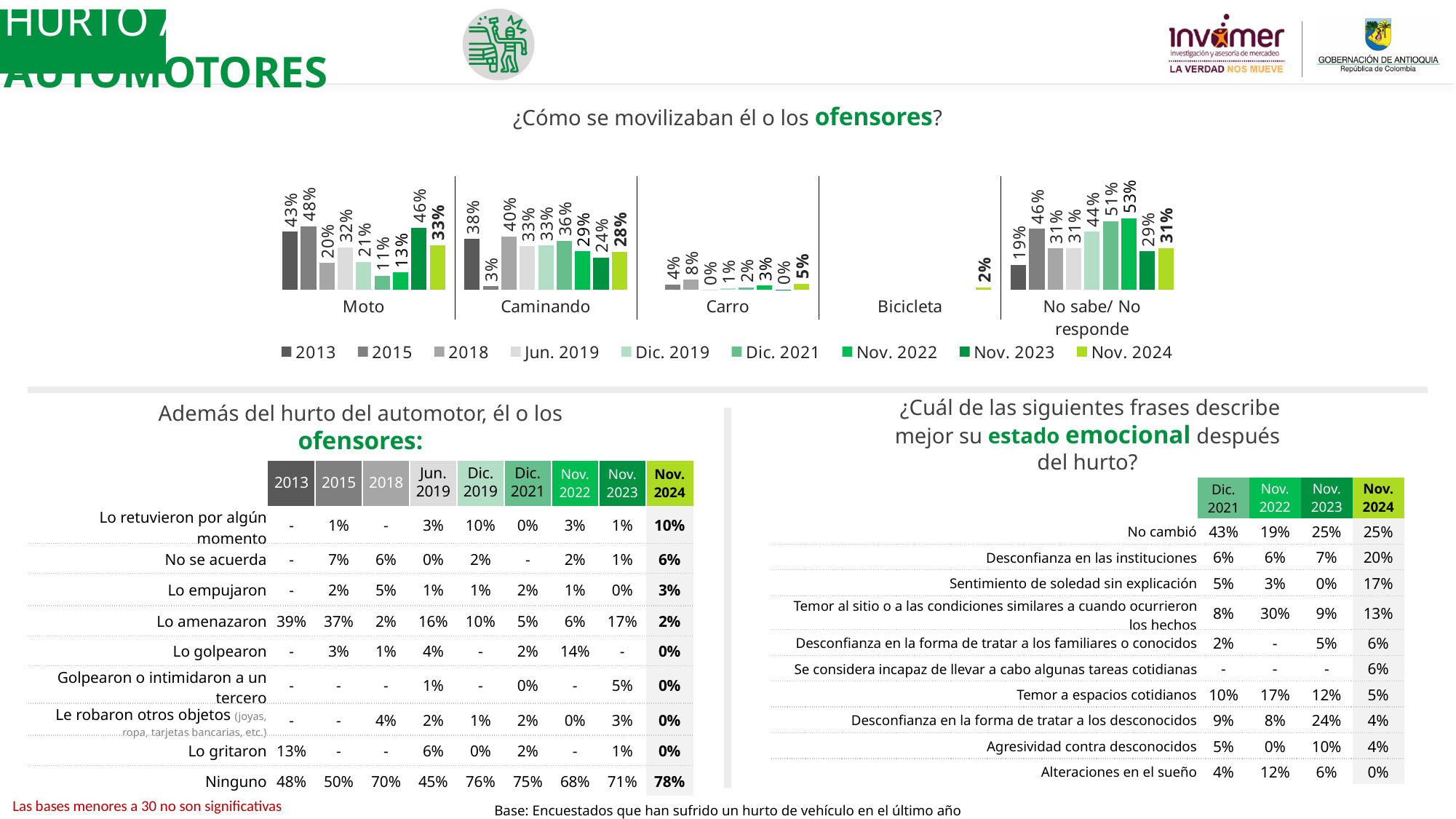
In the chart '¿Cómo se movilizaban él o los ofensores?', what is the difference between the 2015 and 2013 values for Moto? 5 percentage points How many series does the legend of the chart '¿Cómo se movilizaban él o los ofensores?' list? 9 How many categories are shown along the x axis of the chart '¿Cómo se movilizaban él o los ofensores?'? 5 In the chart '¿Cómo se movilizaban él o los ofensores?', what is the 2013 value for Caminando? 38% In the chart '¿Cómo se movilizaban él o los ofensores?', for Nov. 2024, which is larger: Moto or Caminando? Moto In the chart '¿Cómo se movilizaban él o los ofensores?', what is the Nov. 2022 value for No sabe/ No responde? 53% In the chart '¿Cómo se movilizaban él o los ofensores?', which year has the highest value for Moto? 2015 What kind of chart is used to show how the offenders were moving (¿Cómo se movilizaban él o los ofensores?)? Bar chart In the chart '¿Cómo se movilizaban él o los ofensores?', what is the Nov. 2024 value for Bicicleta? 2% In the chart '¿Cómo se movilizaban él o los ofensores?', what is the Nov. 2024 value for Carro? 5% In the chart '¿Cómo se movilizaban él o los ofensores?', what is the Nov. 2024 value for Moto? 33% In the chart '¿Cómo se movilizaban él o los ofensores?', which year has the lowest value for Moto? Dic. 2021